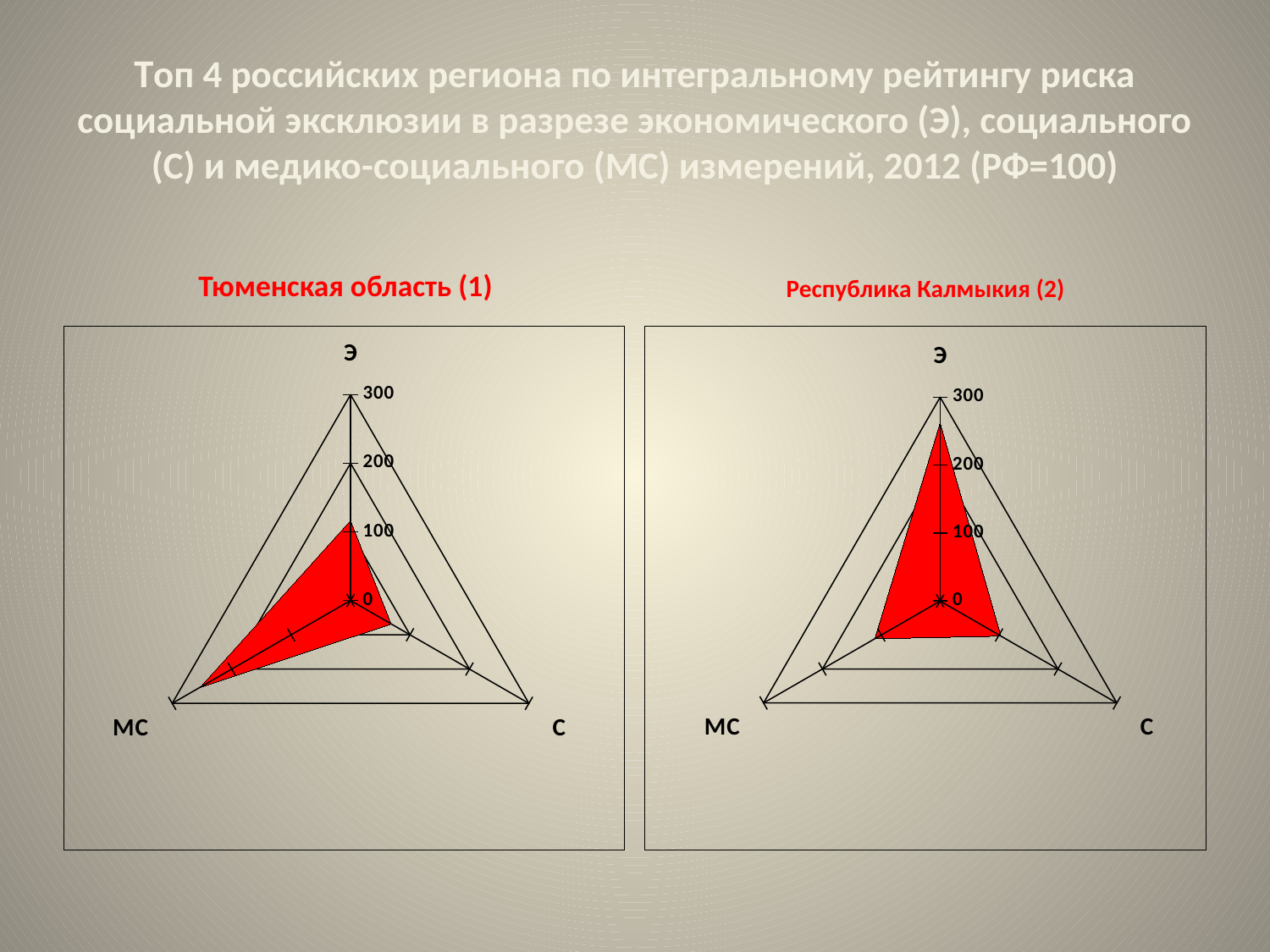
In the Республика Калмыкия (2) chart, which dimension has the highest value? Э In the Республика Калмыкия (2) chart, is the value for Э greater or less than 200? greater In the Тюменская область (1) chart, which dimension has the lowest value? С How many dimensions (axes) does the Республика Калмыкия (2) chart plot? 3 What kind of chart is used for Тюменская область (1)? radar chart Which region has the larger value for Э: Тюменская область (1) or Республика Калмыкия (2)? Республика Калмыкия (2) In the Республика Калмыкия (2) chart, is the value for Э greater or less than 300? less What is the maximum value shown on the axis scale of the Тюменская область (1) chart? 300 In the Тюменская область (1) chart, which dimension has the highest value? МС In the Тюменская область (1) chart, is the value for С greater or less than 100? less What are the three axis labels on the Республика Калмыкия (2) chart? Э, С, МС